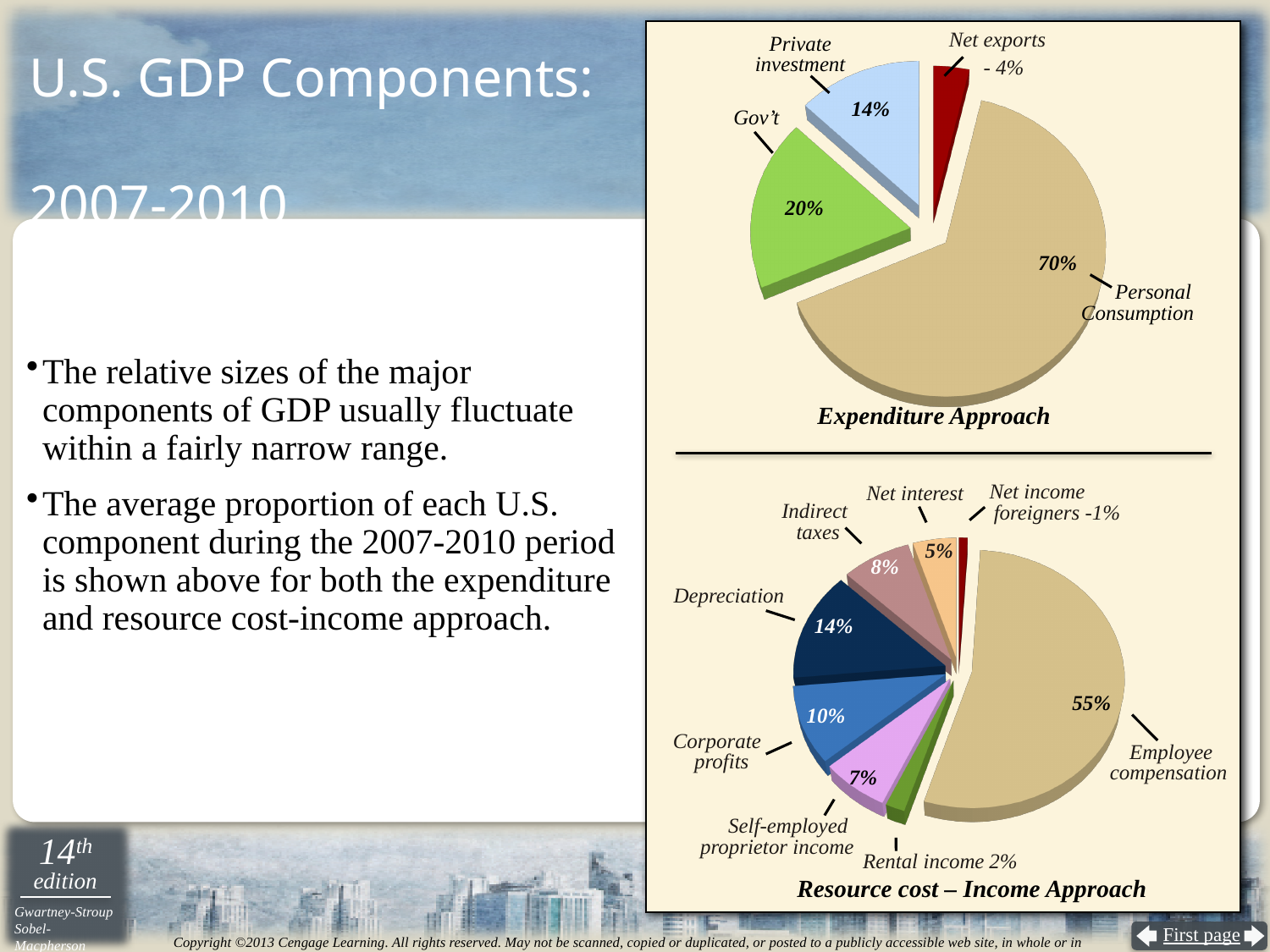
In the Resource cost – Income Approach pie chart, how many slices are there? 8 In the Expenditure Approach pie chart, which component has the largest share? Personal Consumption In the Expenditure Approach pie chart, what value is shown for Net exports? -4% In the Resource cost – Income Approach pie chart, what share is Rental income? 2% In the Resource cost – Income Approach pie chart, which is larger, Corporate profits or Indirect taxes? Corporate profits In the Expenditure Approach pie chart, what share is Gov't? 20% In the Resource cost – Income Approach pie chart, what share is Depreciation? 14% In the Expenditure Approach pie chart, how many slices are there? 4 In the Expenditure Approach pie chart, what is the difference between Gov't and Private investment? 6% In the Resource cost – Income Approach pie chart, what share is Employee compensation? 55% What type of chart is used for the Expenditure Approach? Pie chart In the Expenditure Approach pie chart, what share is Personal Consumption? 70%